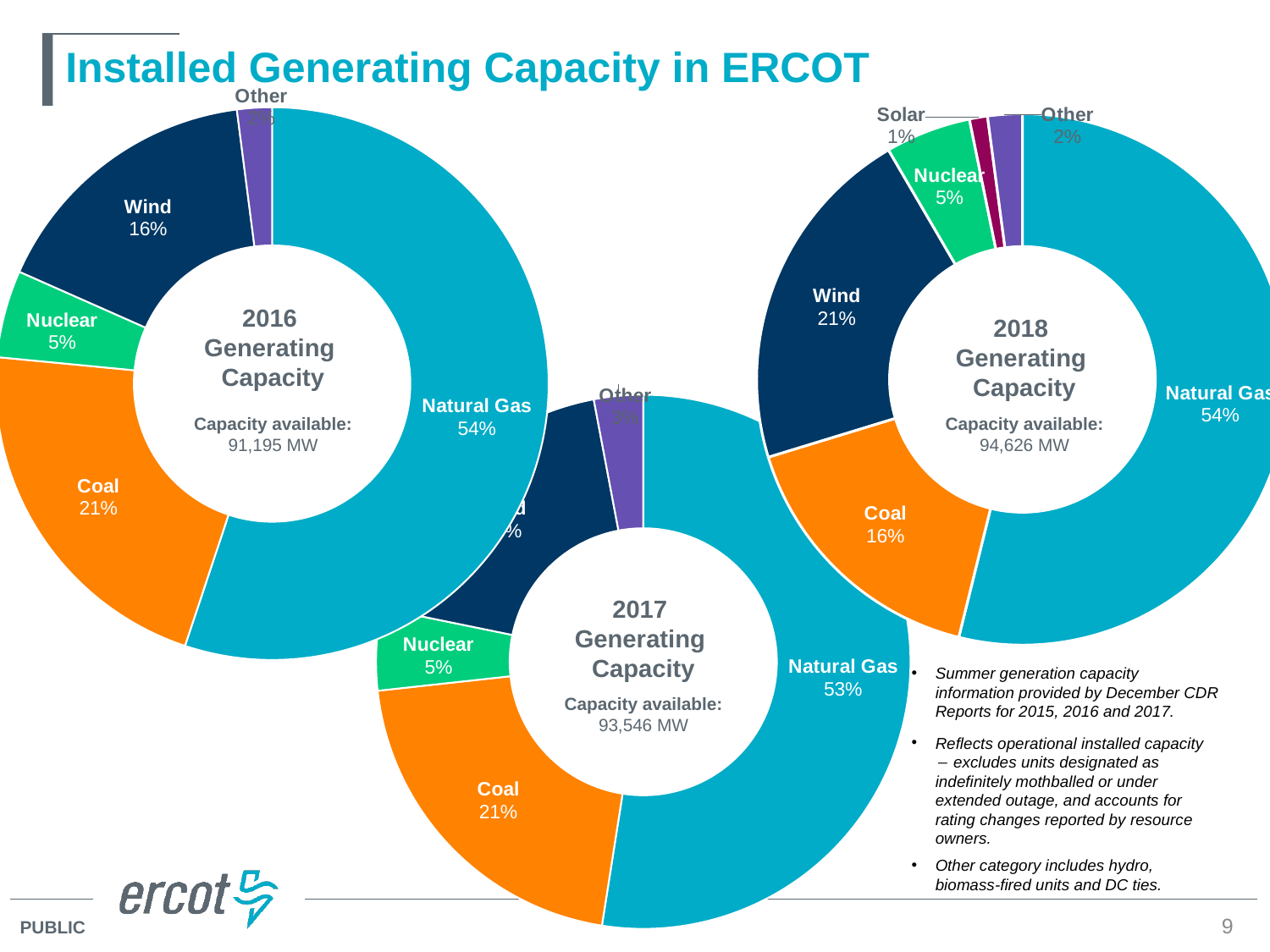
In the 2016 Generating Capacity chart, what is the capacity available shown in the centre? 91,195 MW In the 2018 Generating Capacity chart, what share does Solar have? 1% In the 2016 Generating Capacity chart, which is larger, the Coal share or the Wind share? Coal In the 2018 Generating Capacity chart, which category has the smallest share? Solar What kind of chart is used for the 2018 Generating Capacity? Pie (donut) chart In the 2016 Generating Capacity chart, what share does Wind have? 16% In the 2018 Generating Capacity chart, what is the difference between the Wind share and the Coal share? 5% In the 2017 Generating Capacity chart, what is the capacity available shown in the centre? 93,546 MW In the 2018 Generating Capacity chart, what share does Coal have? 16% In the 2017 Generating Capacity chart, what share does Natural Gas have? 53% In the 2018 Generating Capacity chart, which category has the largest share? Natural Gas In the 2016 Generating Capacity chart, what share does Natural Gas have? 54%